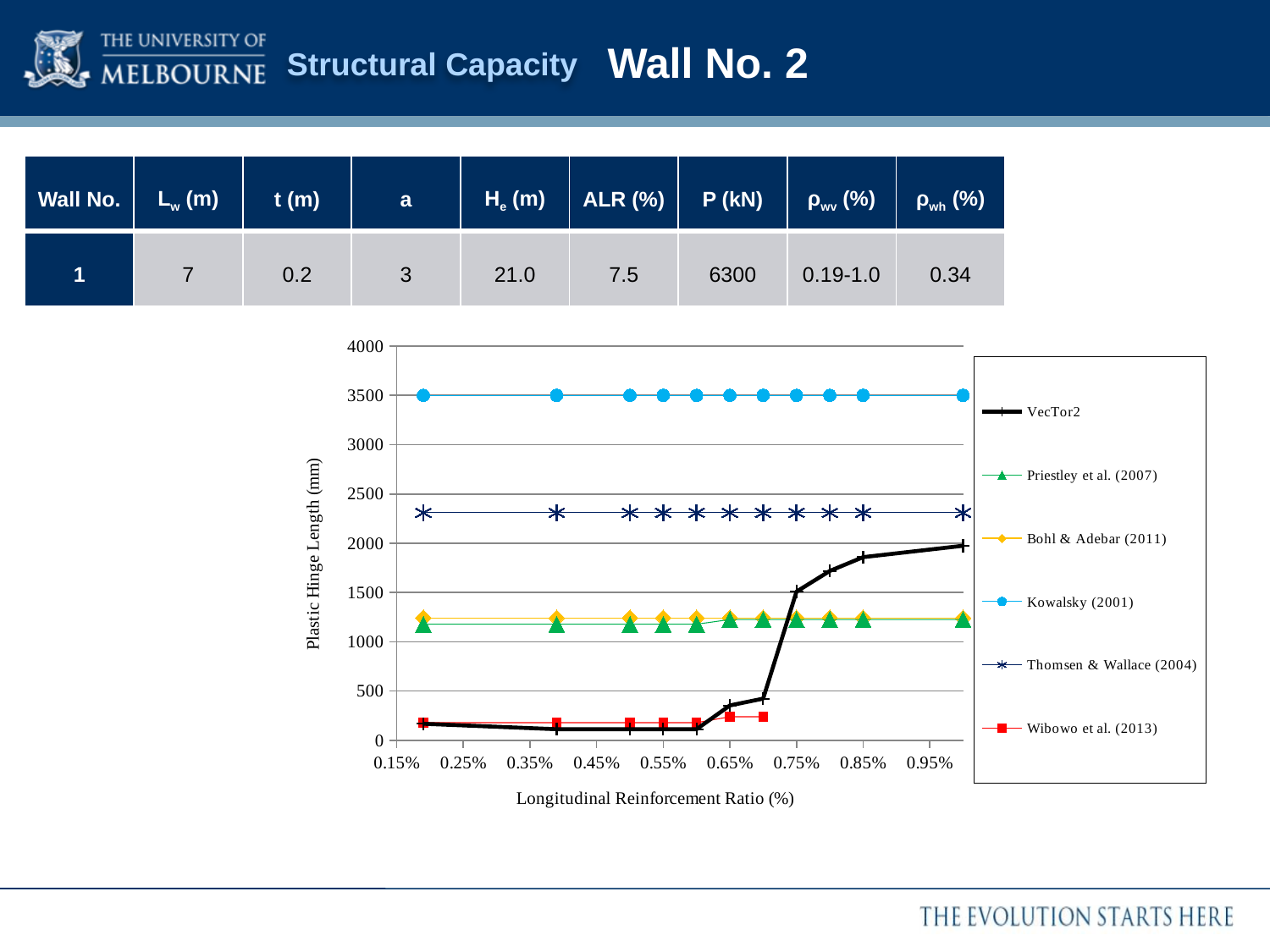
Which series has the highest plastic hinge length values across the chart? Kowalsky (2001) What is the title of the chart's vertical axis? Plastic Hinge Length (mm) Which series has larger values, Thomsen & Wallace (2004) or Bohl & Adebar (2011)? Thomsen & Wallace (2004) What is the title of the chart's horizontal axis? Longitudinal Reinforcement Ratio (%) Do the VecTor2 values rise or fall as the longitudinal reinforcement ratio increases? rise Do the Kowalsky (2001) values rise, fall or stay flat as the longitudinal reinforcement ratio increases? stay flat Are the values for Thomsen & Wallace (2004) greater or less than 2000? greater What kind of chart is shown on the slide? line chart How many series does the chart legend list? 6 Are the values for Kowalsky (2001) greater or less than 3000? greater